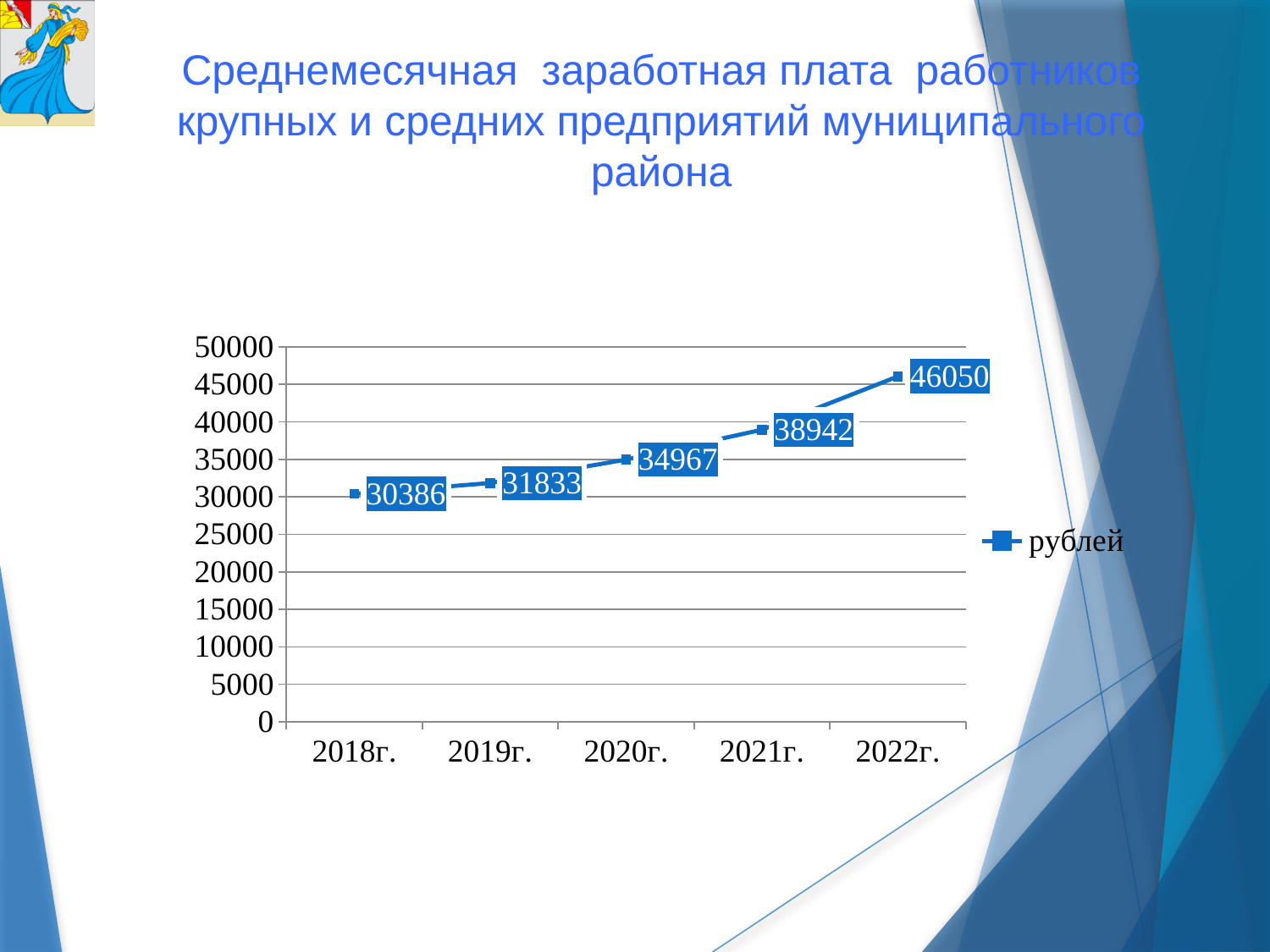
What kind of chart is shown on the slide? line chart What is the difference between the values for 2022г. and 2021г.? 7108 Which is larger, the value for 2021г. or the value for 2020г.? 2021г. Which year has the lowest value? 2018г. What is the value for 2018г.? 30386 What is the value for 2020г.? 34967 Is the value for 2021г. greater or less than 35000? greater How many years are plotted on the chart? 5 Which year has the highest value? 2022г. What is the difference between the values for 2019г. and 2018г.? 1447 Do the values rise or fall from 2018г. to 2022г.? rise What is the value for 2022г.? 46050